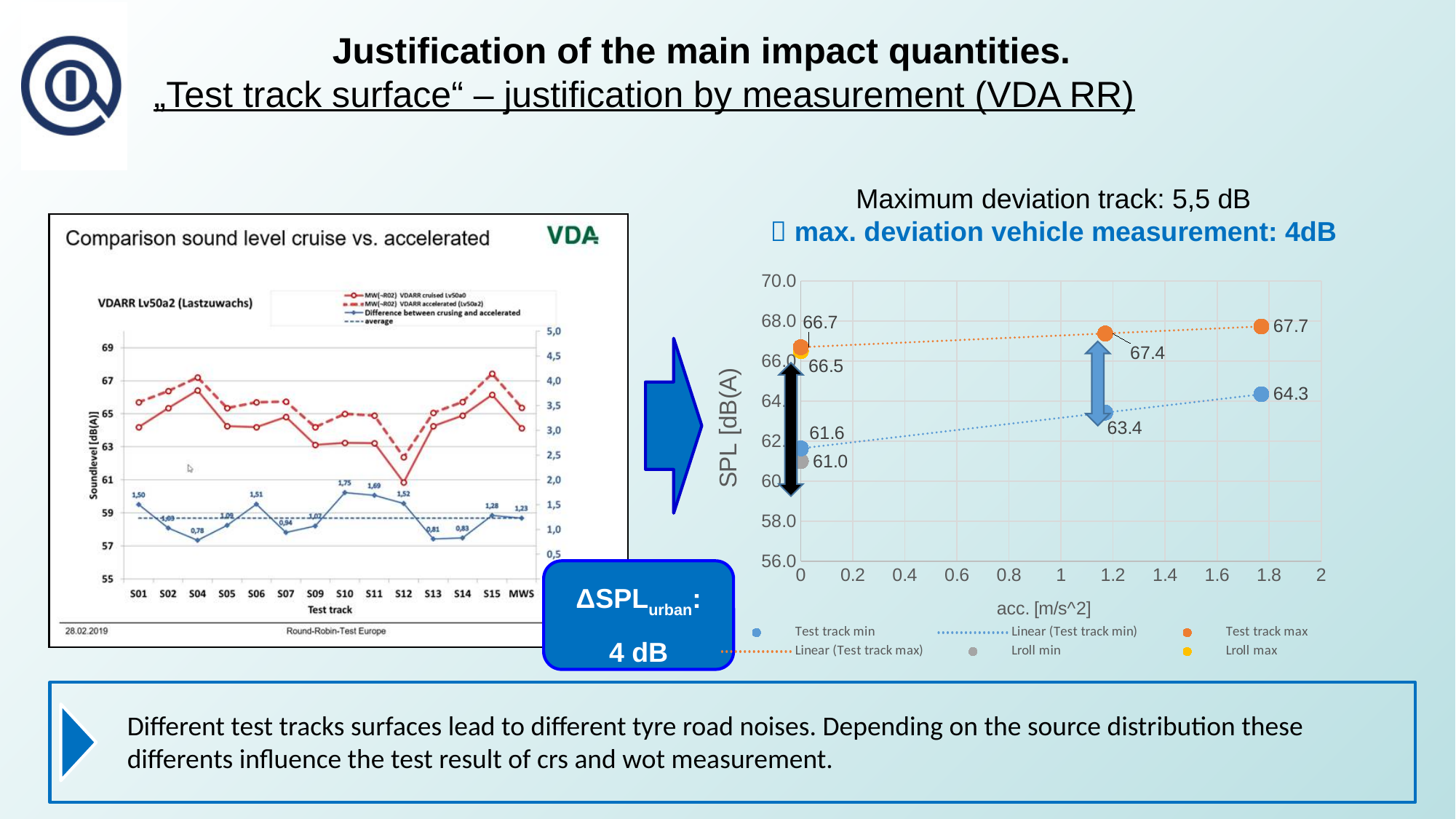
In the left-hand chart (Comparison sound level cruise vs. accelerated), how many test tracks are shown on the x axis? 14 In the right-hand chart (SPL vs. acc.), what is the data label for the Lroll min point? 61.0 In the right-hand chart (SPL vs. acc.), do the Test track min values rise or fall as acceleration increases? rise In the right-hand chart (SPL vs. acc.), what is the label of the y axis? SPL [dB(A)] In the right-hand chart (SPL vs. acc.), which is larger: the Lroll max value or the Lroll min value? Lroll max In the left-hand chart (Comparison sound level cruise vs. accelerated), what is the labelled difference value for MWS? 1,23 In the right-hand chart (SPL vs. acc.), what is the data label for the Test track max point at acc. 0? 66.7 In the left-hand chart (Comparison sound level cruise vs. accelerated), what is the labelled difference between cruising and accelerated for test track S10? 1,75 In the right-hand chart (SPL vs. acc.), what is the difference between the Test track max label (67.4) and the Test track min label (63.4) at acc. around 1.2 m/s^2? 4.0 In the right-hand chart (SPL vs. acc.), how many entries does the legend list? 6 In the left-hand chart (Comparison sound level cruise vs. accelerated), which test track has the lowest labelled difference between cruising and accelerated? S04 In the right-hand chart (SPL vs. acc.), what is the data label for the Test track min point at the highest acceleration (around 1.8 m/s^2)? 64.3